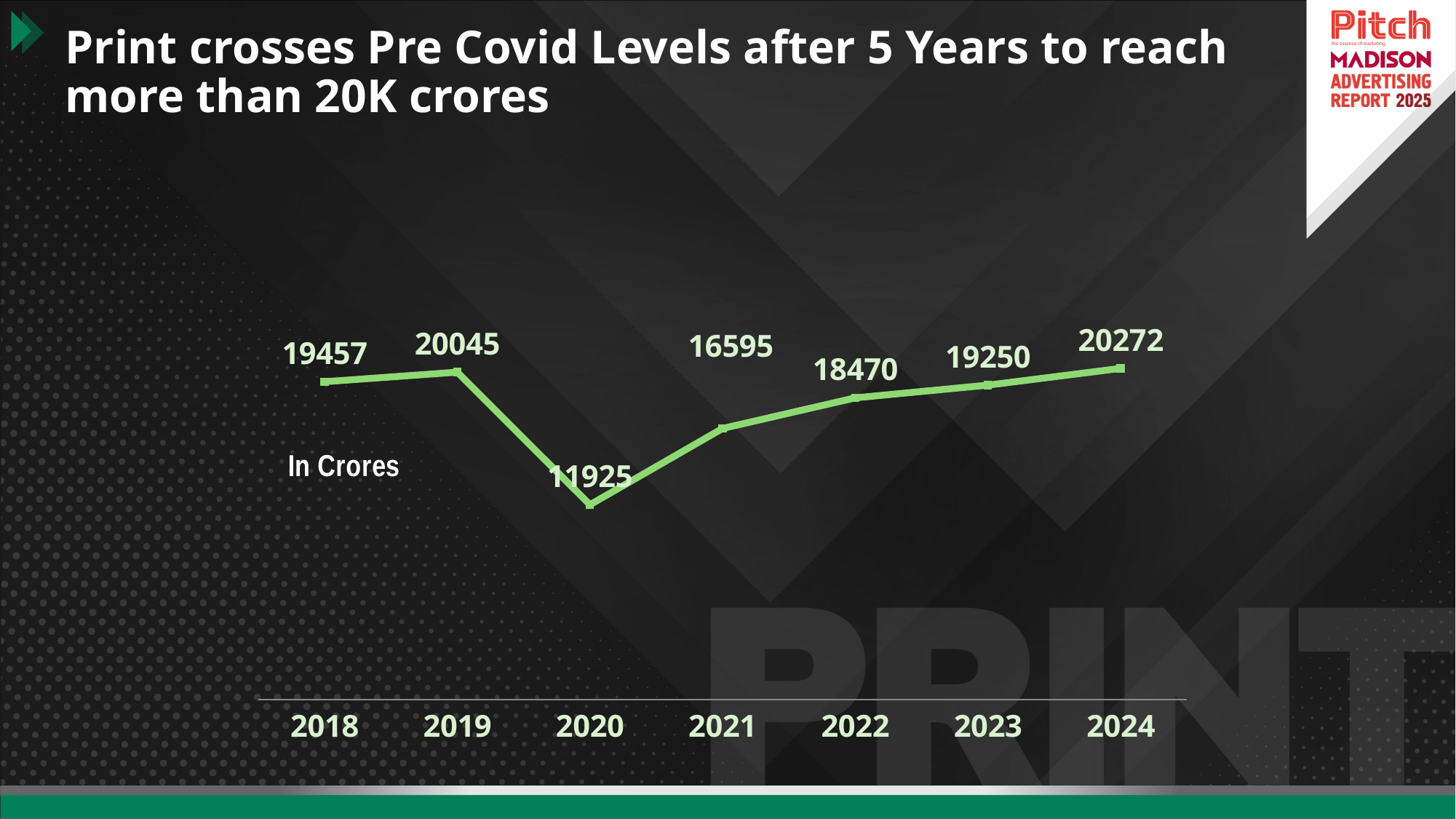
What is the difference between the values for 2019 and 2020? 8120 What is the value for 2019? 20045 What is the value for 2024? 20272 Which is larger, the value for 2018 or the value for 2021? 2018 What kind of chart is shown on the slide? line chart Which year has the lowest value? 2020 What unit label is shown on the chart? In Crores What is the difference between the values for 2024 and 2023? 1022 Which year has the highest value? 2024 How many years are plotted on the chart? 7 What is the value for 2020? 11925 Do the values rise or fall from 2020 to 2024? rise